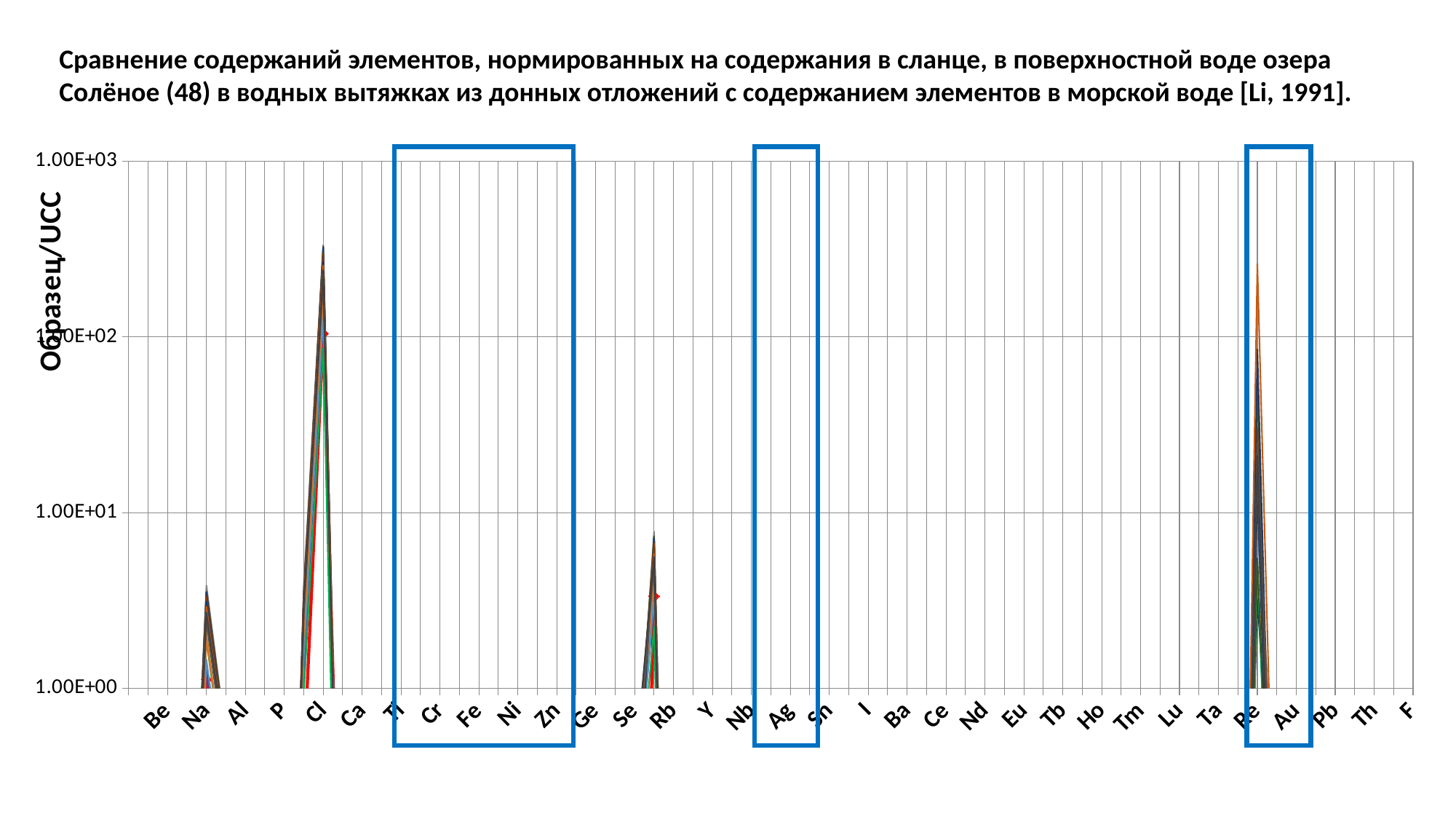
Is the peak value at Cl greater or less than 1.00E+02? greater Is the peak value at Rb greater or less than 1.00E+01? less Which element has the highest peak on the chart? Cl What kind of chart is shown on the slide? line chart What is the label of the vertical axis? Образец/UCC Is the peak value at Na greater or less than 1.00E+01? less Which peak is higher, the one at Na or the one at Rb? Rb What is the highest value shown on the vertical axis? 1.00E+03 Which peak is higher, the one at Cl or the one at Rb? Cl